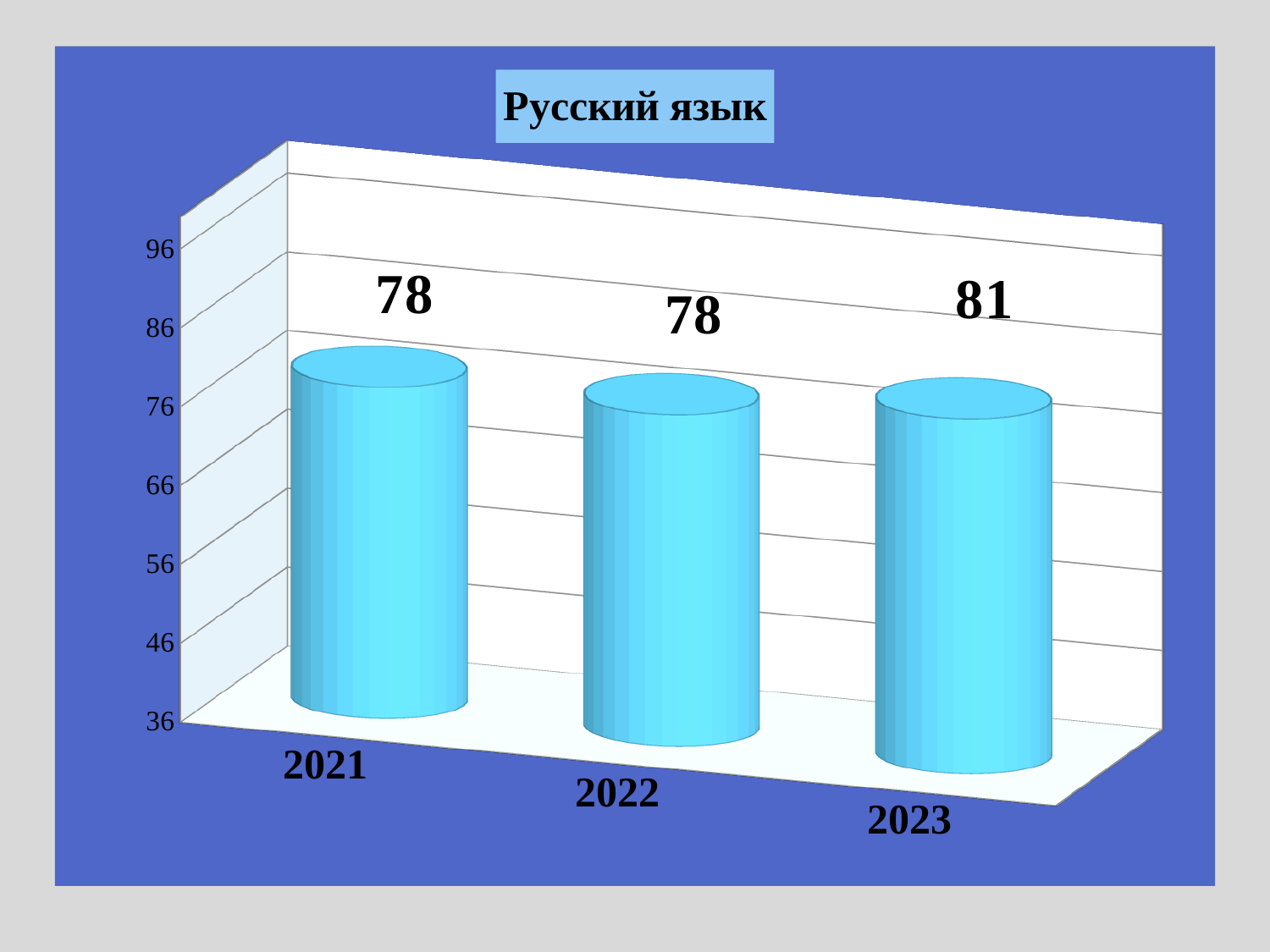
What is the value for 2022? 78 Is the value for 2023 greater or less than 76? greater What is the lowest value shown on the vertical axis? 36 What is the value for 2023? 81 Do the values rise or fall from 2022 to 2023? rise What kind of chart is shown on the slide? bar chart How many years are shown on the x axis? 3 Which is larger, the value for 2022 or the value for 2023? 2023 What is the title of the chart? Русский язык What is the value for 2021? 78 Which year has the highest value? 2023 What is the difference between the values for 2023 and 2021? 3